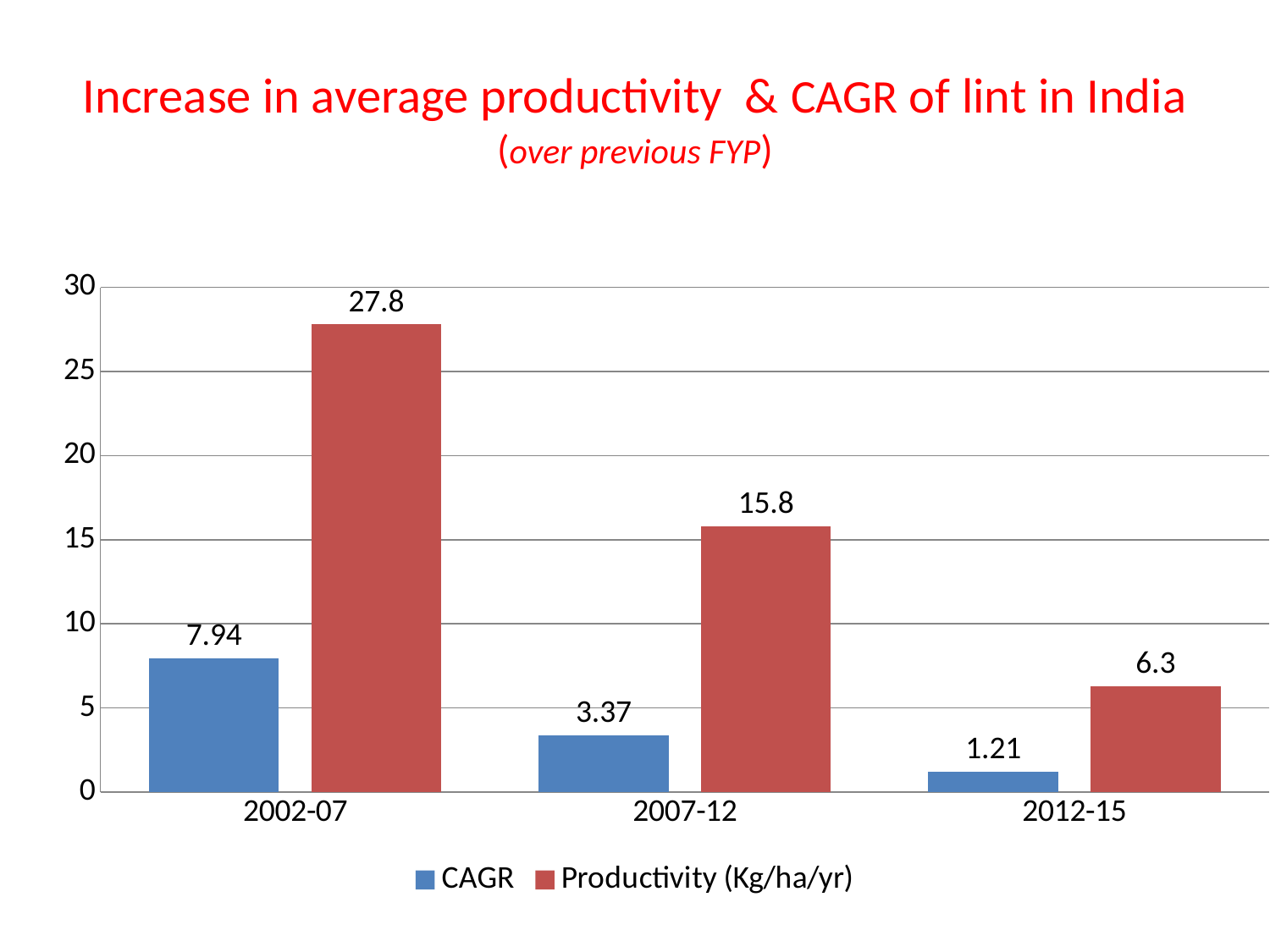
How many series does the legend list? 2 What is the Productivity (Kg/ha/yr) value for 2007-12? 15.8 How many periods are shown on the x axis? 3 Which period has the lowest CAGR value? 2012-15 Which is larger: the CAGR for 2007-12 or the Productivity (Kg/ha/yr) for 2012-15? Productivity (Kg/ha/yr) for 2012-15 What is the CAGR value for 2012-15? 1.21 Which period has the highest Productivity (Kg/ha/yr) value? 2002-07 What kind of chart is shown on the slide? bar chart What is the difference between the Productivity (Kg/ha/yr) values for 2002-07 and 2007-12? 12 Do the CAGR values rise or fall from 2002-07 to 2012-15? fall What is the CAGR value for 2002-07? 7.94 Is the Productivity (Kg/ha/yr) value for 2002-07 greater or less than 25? greater